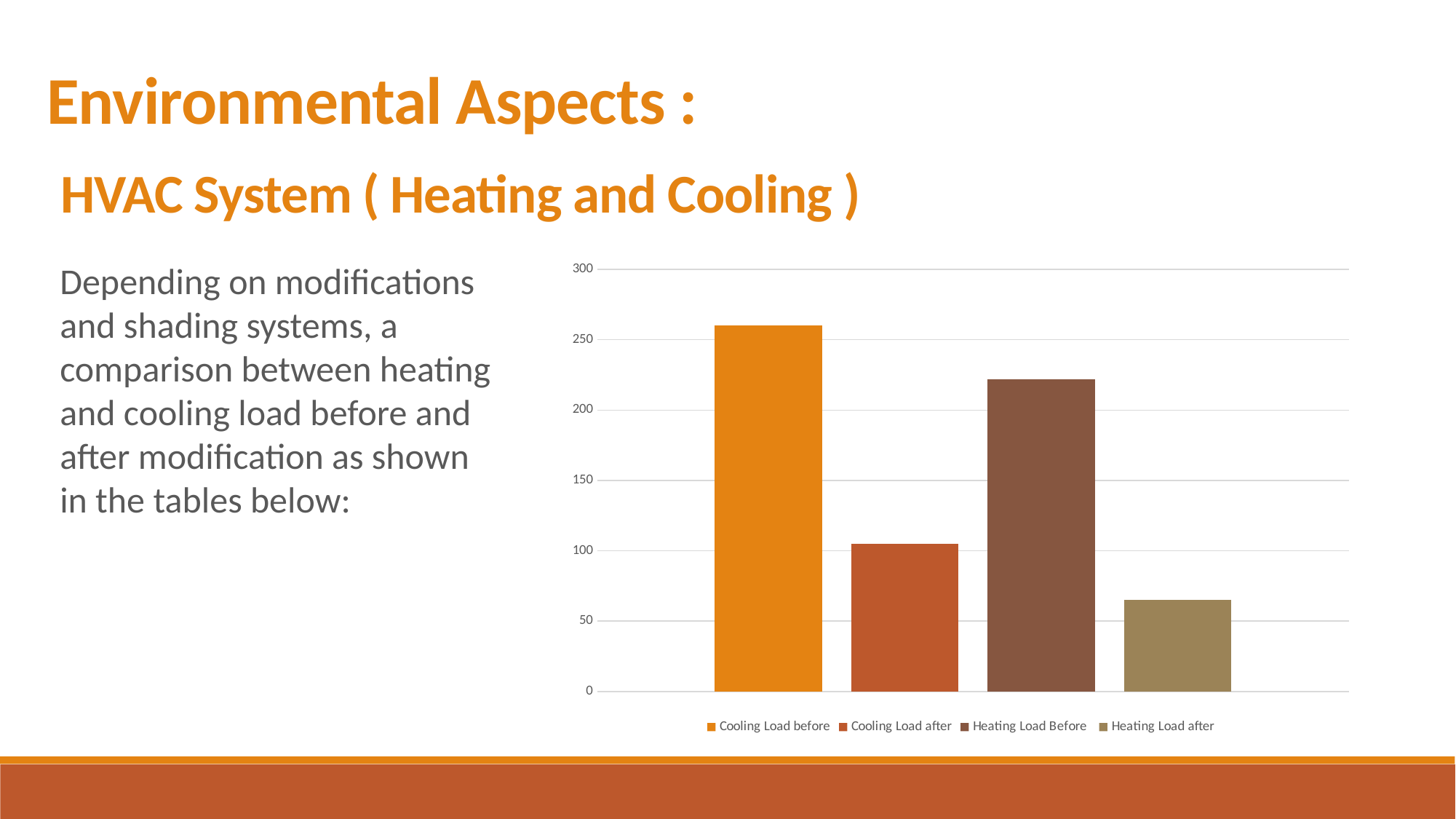
Which is larger, Cooling Load after or Heating Load after? Cooling Load after Is the value for Heating Load Before greater or less than 200? greater Which is larger, Cooling Load before or Heating Load Before? Cooling Load before Which series has the lowest bar in the chart? Heating Load after Is the value for Heating Load after greater or less than 100? less What is the highest value shown on the chart's vertical axis? 300 What kind of chart is shown on the slide? bar chart Which series has the highest bar in the chart? Cooling Load before How many bars are plotted in the chart? 4 How many series does the chart legend list? 4 Is the value for Cooling Load before greater or less than 250? greater